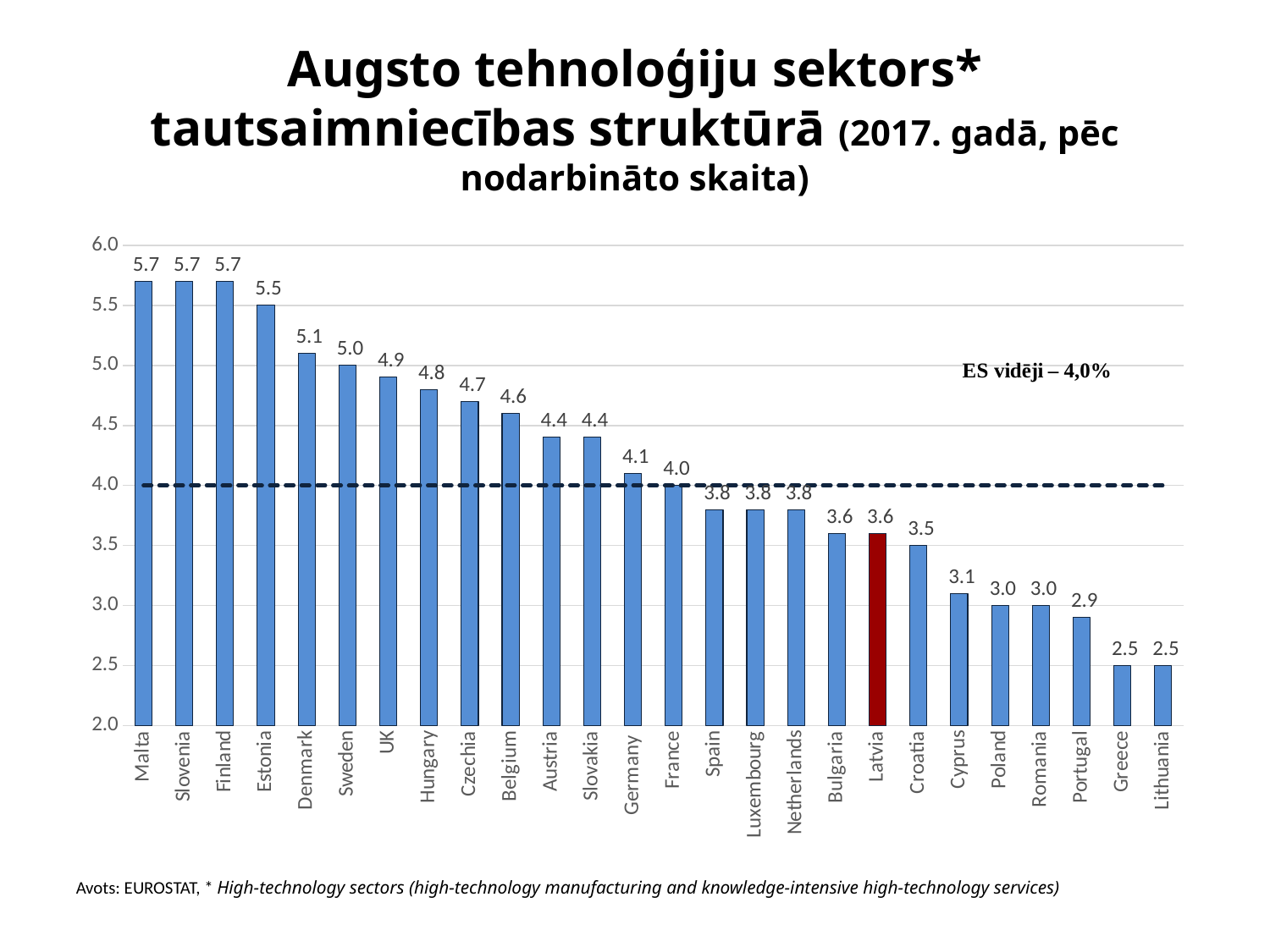
Which has a larger value, Hungary or Spain? Hungary What is the value for Germany? 4.1 What is the difference between the values for Malta and Latvia? 2.1 Which has a larger value, Cyprus or Belgium? Belgium Do the values rise or fall from left to right along the x axis? Fall How many countries are shown on the chart? 26 What is the value for Denmark? 5.1 What is the value for Latvia? 3.6 What is the value for Portugal? 2.9 What is the difference between the values for Estonia and Croatia? 2.0 What kind of chart is shown on the slide? Bar chart What EU average value is indicated by the dashed line on the chart? 4,0%